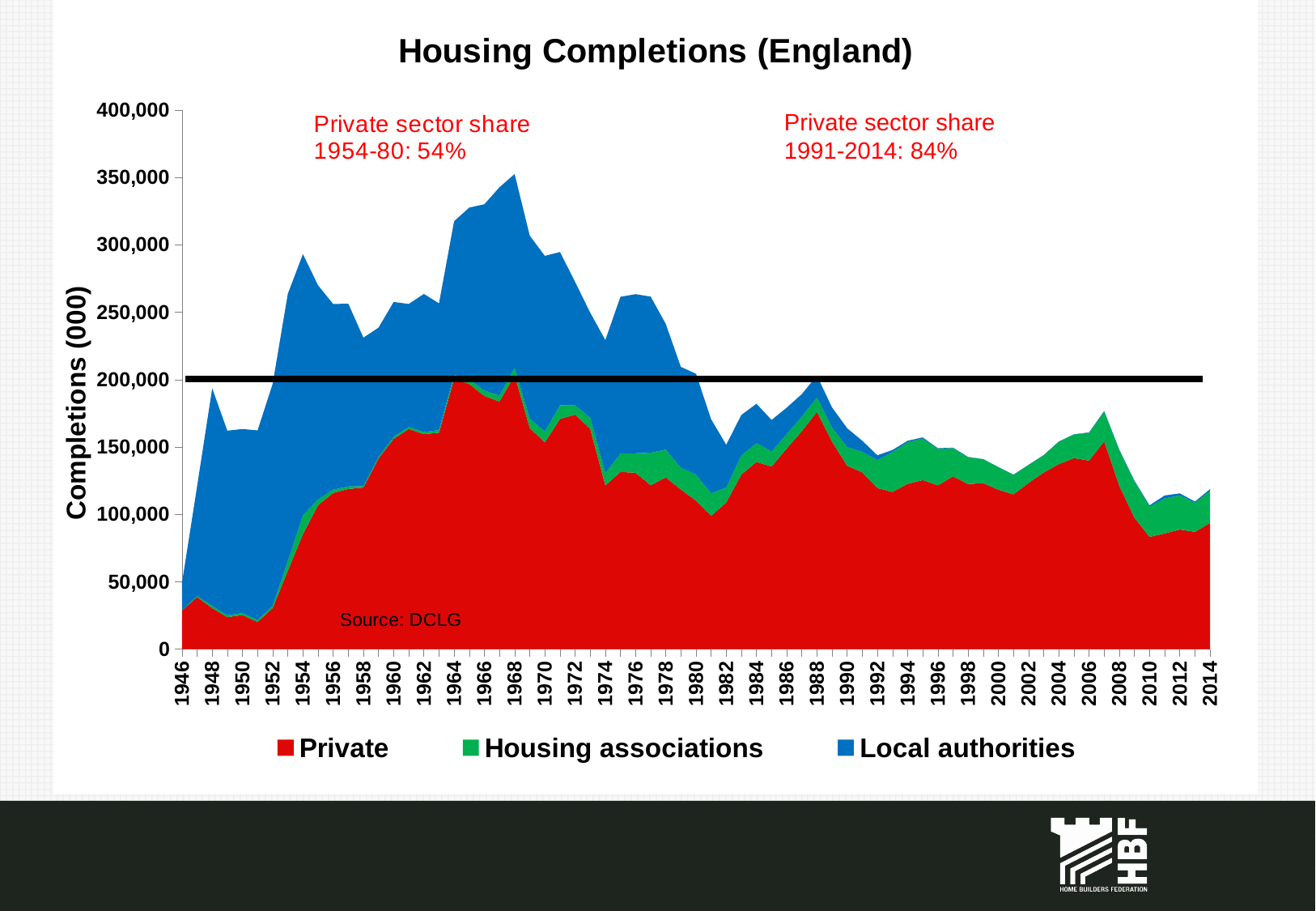
According to the annotation, what was the private sector share of completions in 1954-80? 54% How many series does the legend list? 3 What is the title of the chart? Housing Completions (England) What kind of chart is shown on the slide? Stacked area chart Is the total number of completions in 1968 greater or less than 300,000? greater Which series is shown in blue in the legend? Local authorities In which year does the total of all three series reach its highest point? 1968 According to the annotation, what was the private sector share of completions in 1991-2014? 84% Is the total number of completions in 2010 greater or less than 150,000? less Which year has the larger total of completions, 1968 or 2014? 1968 Do total completions rise or fall between 1968 and 1982? fall